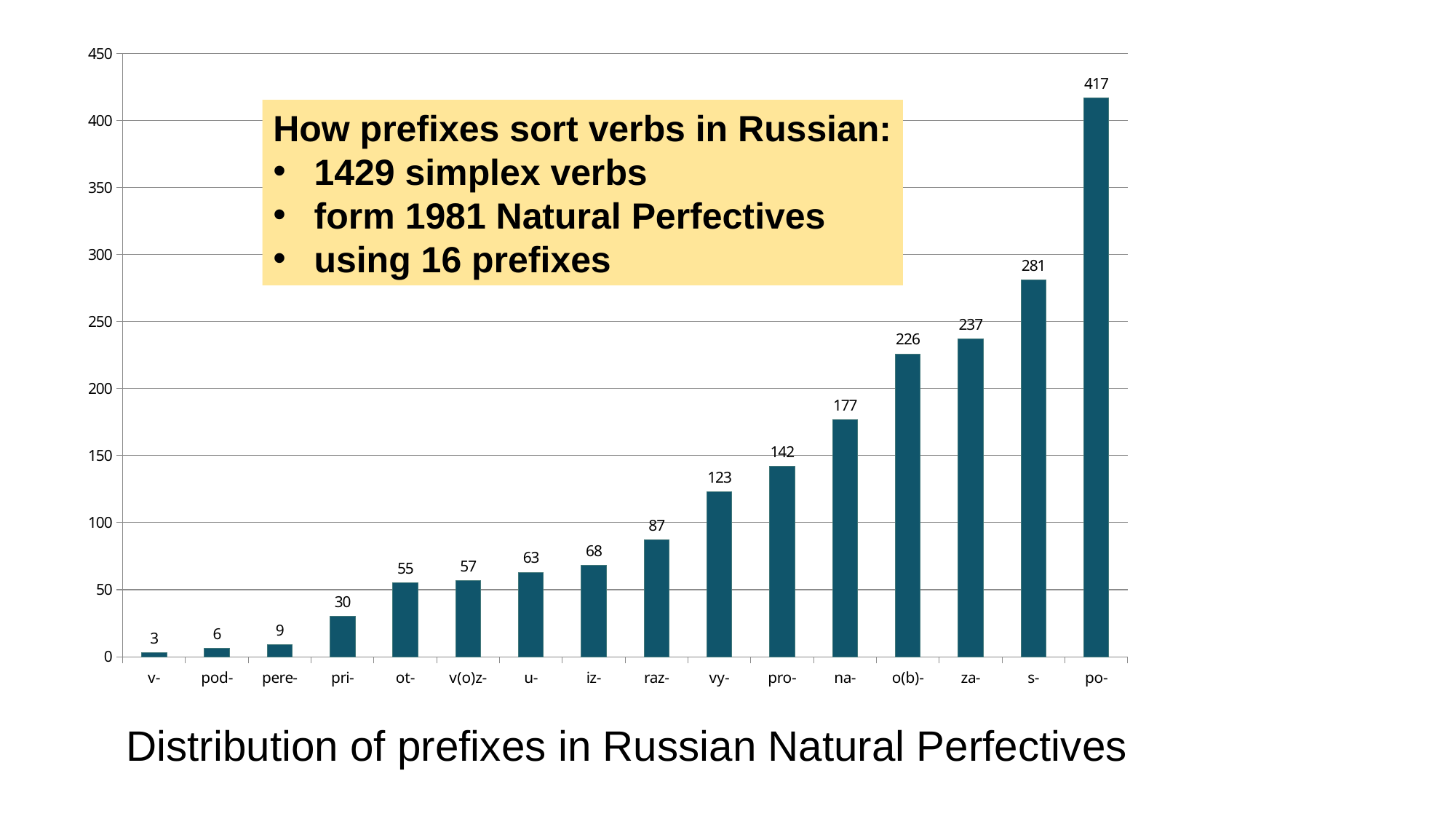
What is the value for the prefix v(o)z-? 57 Do the values rise or fall from left to right along the x axis? rise What kind of chart is shown? bar chart What is the difference between the values for s- and za-? 44 Which prefix has the lowest value? v- What is the value for the prefix na-? 177 What is the difference between the values for po- and s-? 136 Which has a larger value, raz- or vy-? vy- What is the value for the prefix po-? 417 How many prefixes are shown on the x axis? 16 Which prefix has the highest value? po- What is the title of the chart? Distribution of prefixes in Russian Natural Perfectives